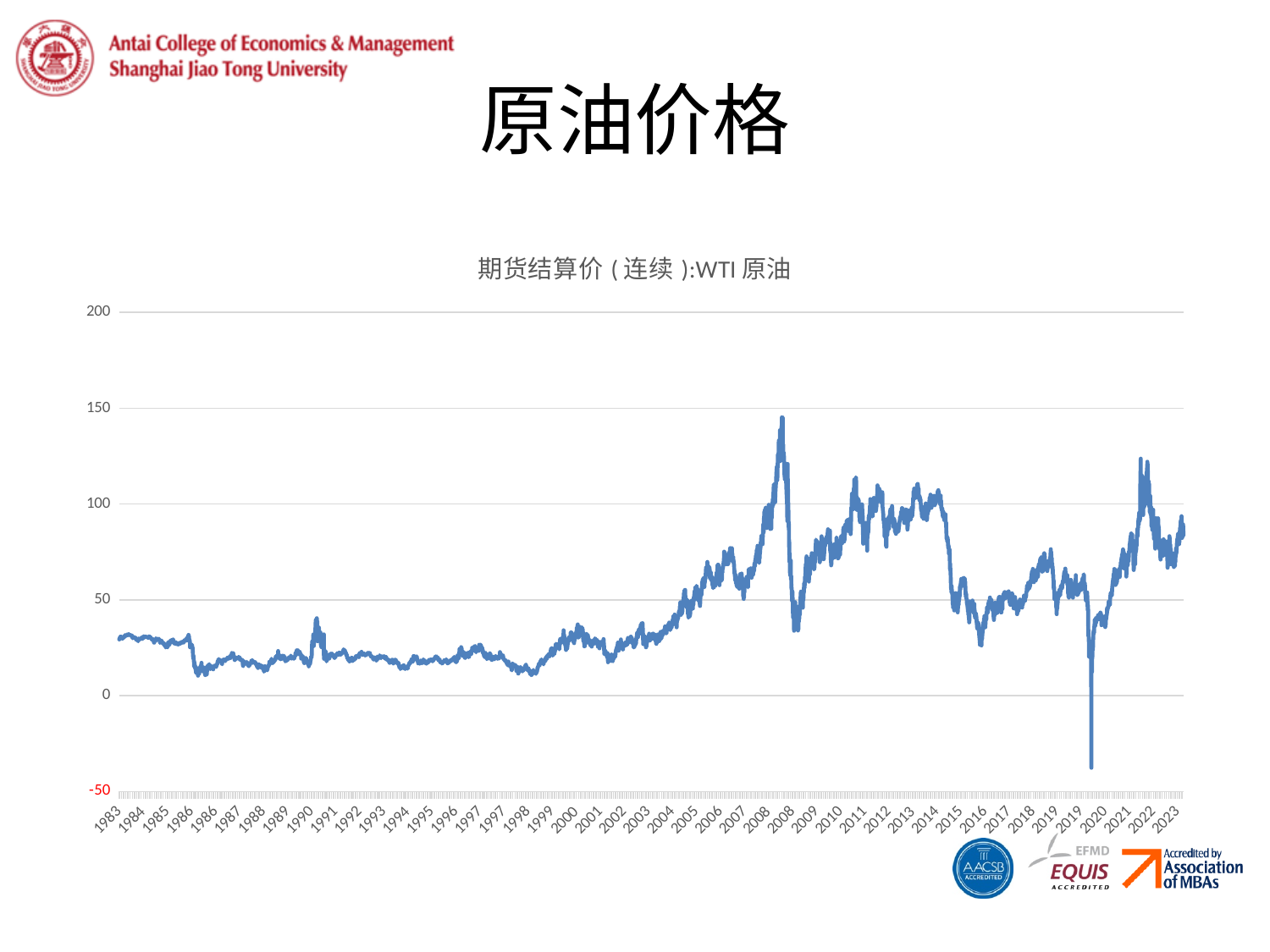
Is the value at the start of the series in 1983 greater or less than 50? less Is the peak value in 2022 greater or less than 100? greater What is the highest value shown on the vertical axis? 200 Does the line generally rise or fall between 1999 and 2008? rise In which year does the line reach its lowest point? 2020 Which is larger, the peak value in 2008 or the peak value in 2022? 2008 What kind of chart is shown on the slide? line chart Is the lowest value in 2020 greater or less than 0? less What is the title of the chart? 期货结算价 ( 连续 ):WTI 原油 In which year does the line reach its highest peak? 2008